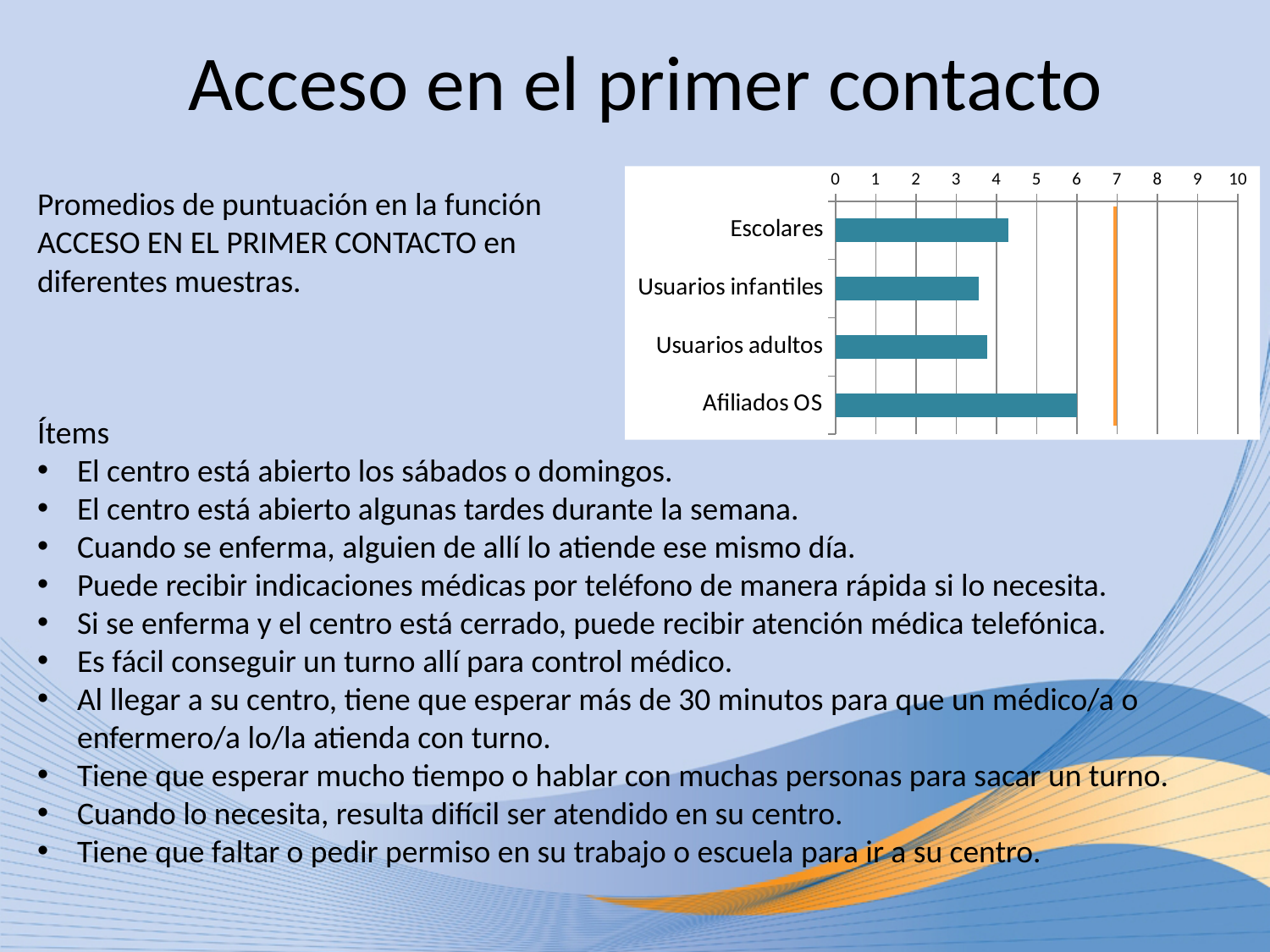
Is the value for Escolares greater or less than 4? greater Which is larger, the value for Escolares or the value for Usuarios infantiles? Escolares Which category has the highest value in the bar chart? Afiliados OS Is the value for Usuarios adultos greater or less than 4? less What kind of chart is shown on the slide? bar chart How many categories are plotted in the bar chart? 4 Is the value for Usuarios infantiles greater or less than 4? less At which axis value is the orange vertical reference line drawn in the chart? 7 What is the maximum value shown on the chart's horizontal axis? 10 Which is larger, the value for Afiliados OS or the value for Escolares? Afiliados OS